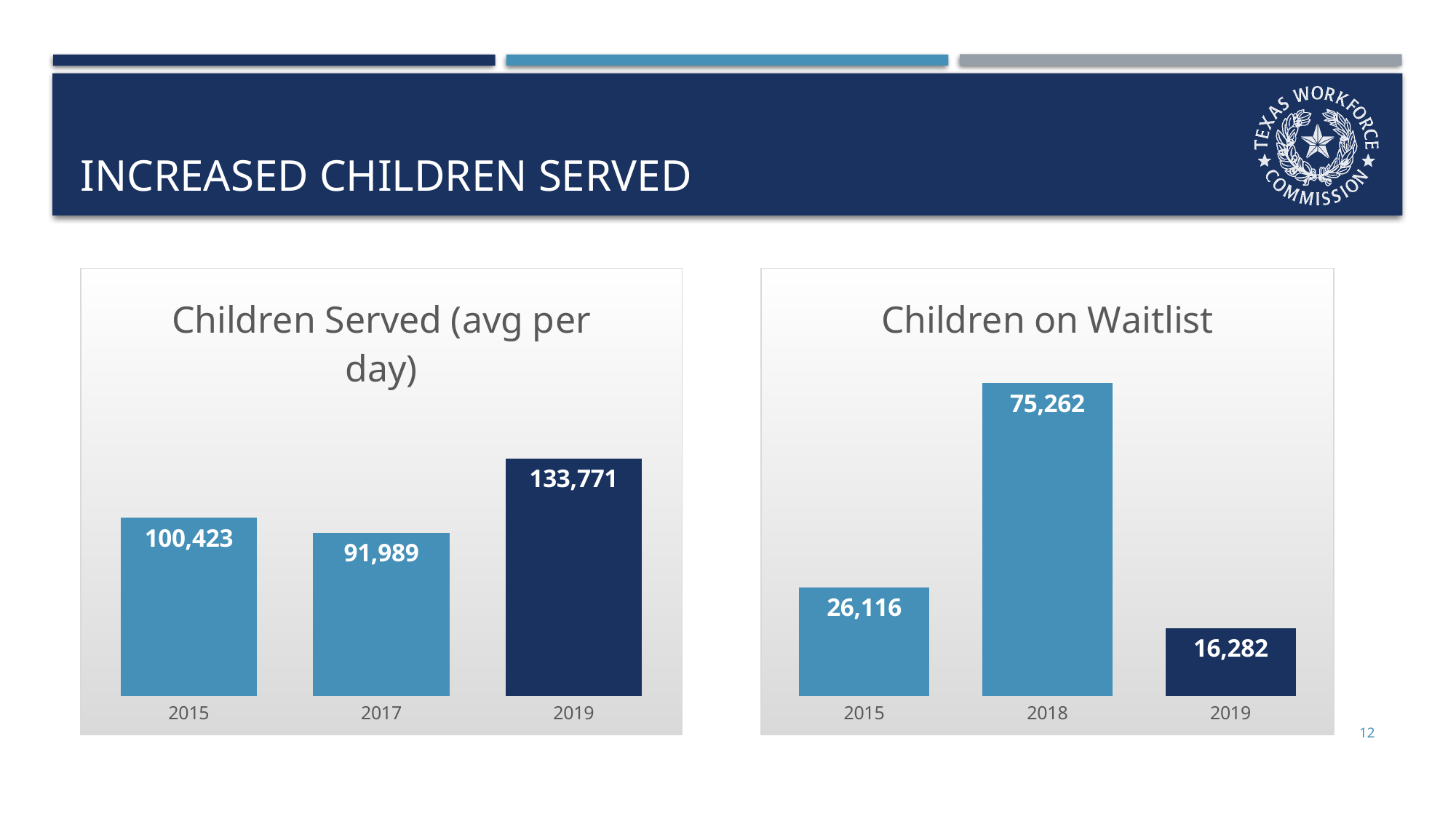
In the 'Children Served (avg per day)' chart, how many years are shown? 3 In the 'Children Served (avg per day)' chart, what is the difference between the 2019 and 2017 values? 41,782 In the 'Children on Waitlist' chart, what is the value for 2018? 75,262 In the 'Children Served (avg per day)' chart, which year has the lowest value? 2017 In the 'Children on Waitlist' chart, what is the difference between the 2018 and 2015 values? 49,146 In the 'Children Served (avg per day)' chart, what is the value for 2015? 100,423 What is the title of the chart on the left side of the slide? Children Served (avg per day) In the 'Children Served (avg per day)' chart, what is the value for 2019? 133,771 In the 'Children on Waitlist' chart, which year has the highest value? 2018 In the 'Children on Waitlist' chart, which is larger, the value for 2015 or the value for 2019? 2015 What kind of chart is the 'Children on Waitlist' chart? Bar chart In the 'Children on Waitlist' chart, what is the value for 2019? 16,282